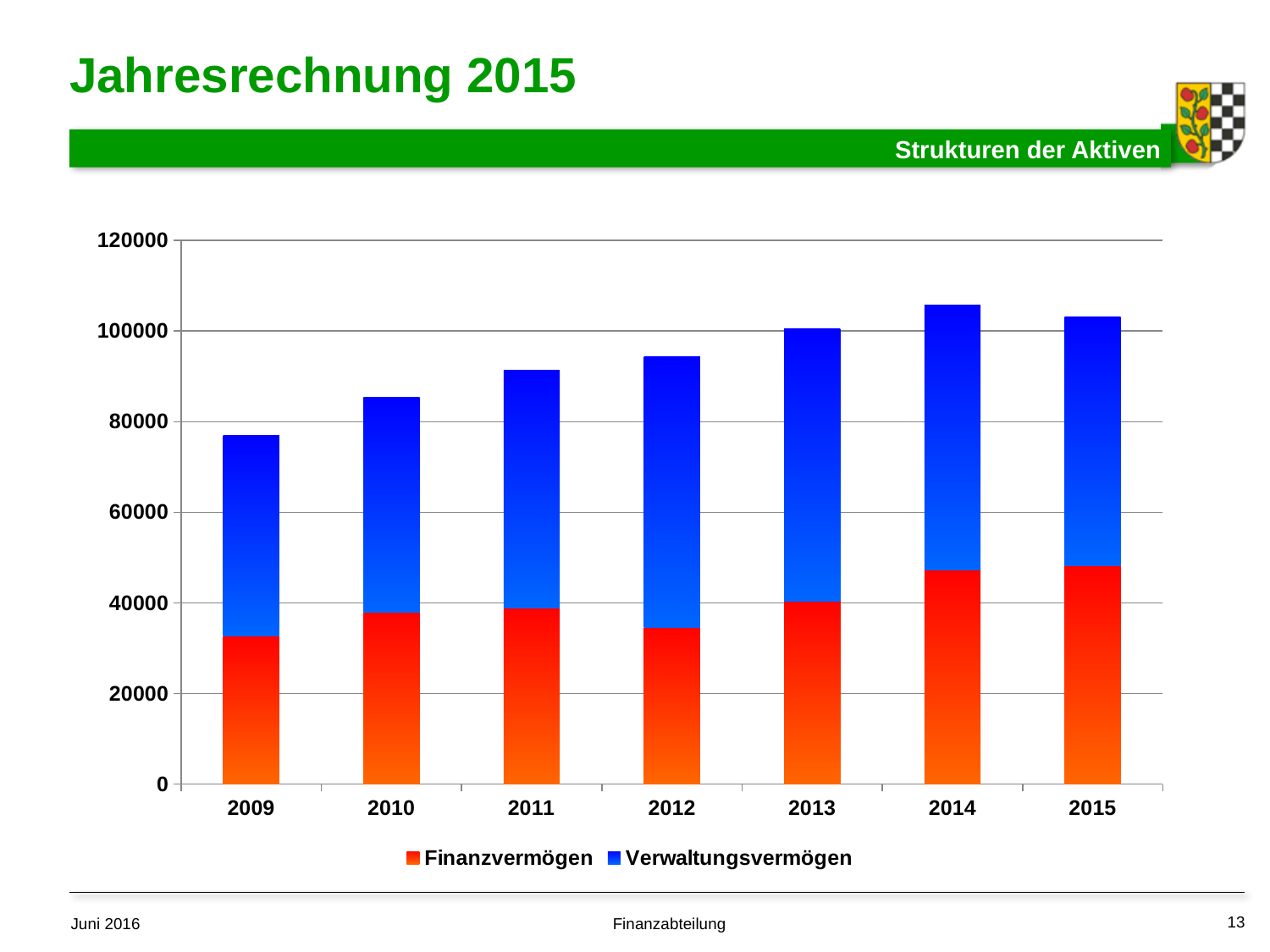
Which year has the larger total bar, 2014 or 2015? 2014 Is the total bar for 2009 greater or less than 80000? less How many series does the chart legend list? 2 Is the Finanzvermögen value for 2014 greater or less than 40000? greater Do the total bar heights rise or fall from 2009 to 2014? rise What kind of chart is shown on the slide? Stacked bar chart Is the total bar for 2014 greater or less than 100000? greater Which series is shown in blue in the chart? Verwaltungsvermögen Which year has the shortest total bar in the chart? 2009 Which year has the tallest total bar in the chart? 2014 How many years are shown on the x axis of the chart? 7